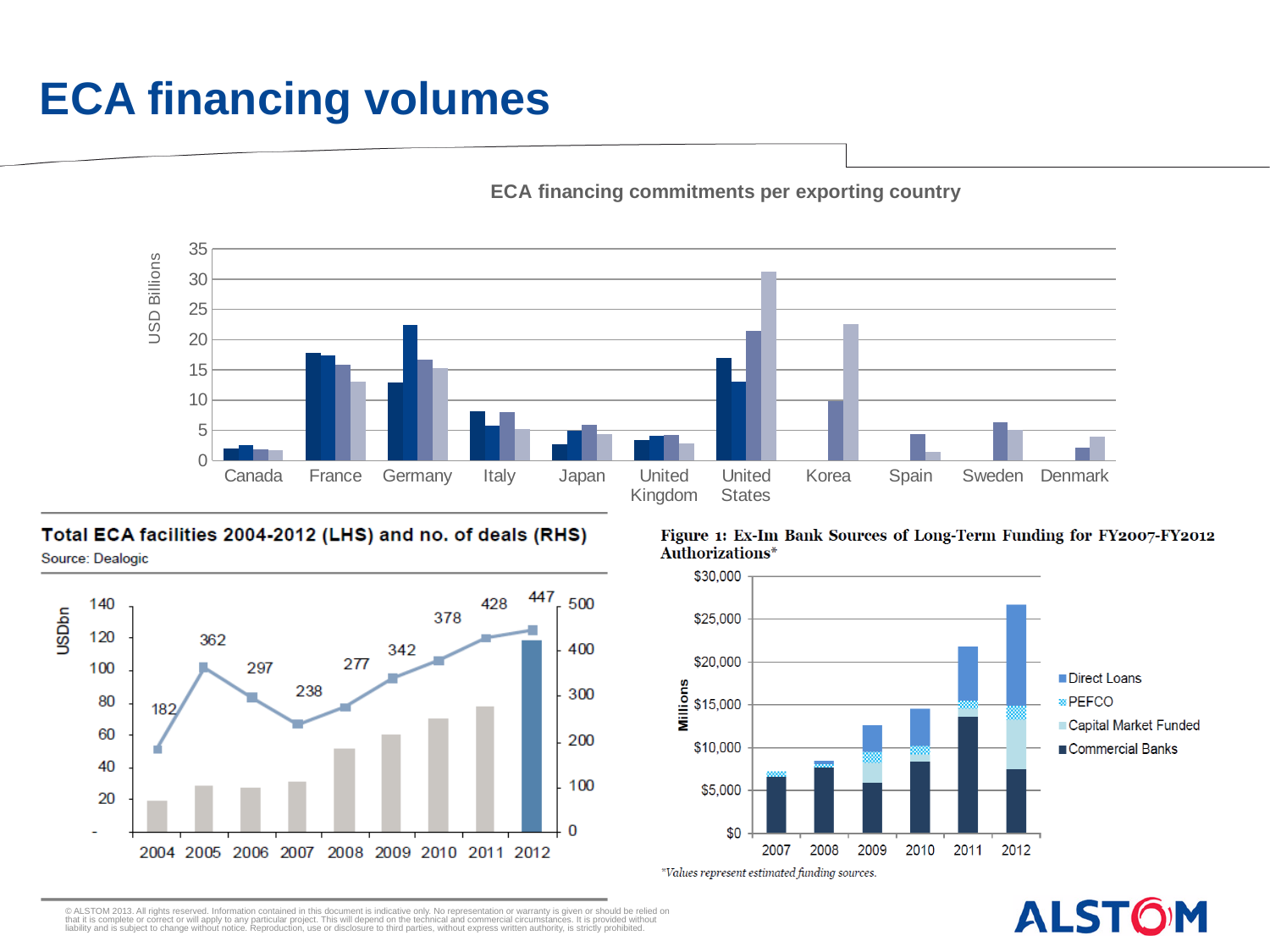
In the 'Total ECA facilities 2004-2012 (LHS) and no. of deals (RHS)' chart, which year has the lowest number of deals? 2004 In the 'Total ECA facilities 2004-2012 (LHS) and no. of deals (RHS)' chart, is the 2012 bar (USDbn) greater or less than 100? greater In the 'Total ECA facilities 2004-2012 (LHS) and no. of deals (RHS)' chart, what is the difference in the number of deals between 2012 and 2011? 19 In the 'Figure 1: Ex-Im Bank Sources of Long-Term Funding' chart, which year has the tallest stacked bar? 2012 In the 'Total ECA facilities 2004-2012 (LHS) and no. of deals (RHS)' chart, does the number of deals rise or fall from 2007 to 2012? rise In the 'Total ECA facilities 2004-2012 (LHS) and no. of deals (RHS)' chart, what is the number of deals in 2004? 182 In the 'ECA financing commitments per exporting country' chart, how many exporting countries are shown on the x axis? 11 In the 'Total ECA facilities 2004-2012 (LHS) and no. of deals (RHS)' chart, what is the number of deals in 2012? 447 In the 'ECA financing commitments per exporting country' chart, are all the bars for Canada greater or less than 5 USD Billions? less In the 'Figure 1: Ex-Im Bank Sources of Long-Term Funding' chart, how many series does the legend list? 4 In the 'ECA financing commitments per exporting country' chart, which country has the single tallest bar? United States In the 'ECA financing commitments per exporting country' chart, is the tallest bar for Germany greater or less than 20 USD Billions? greater